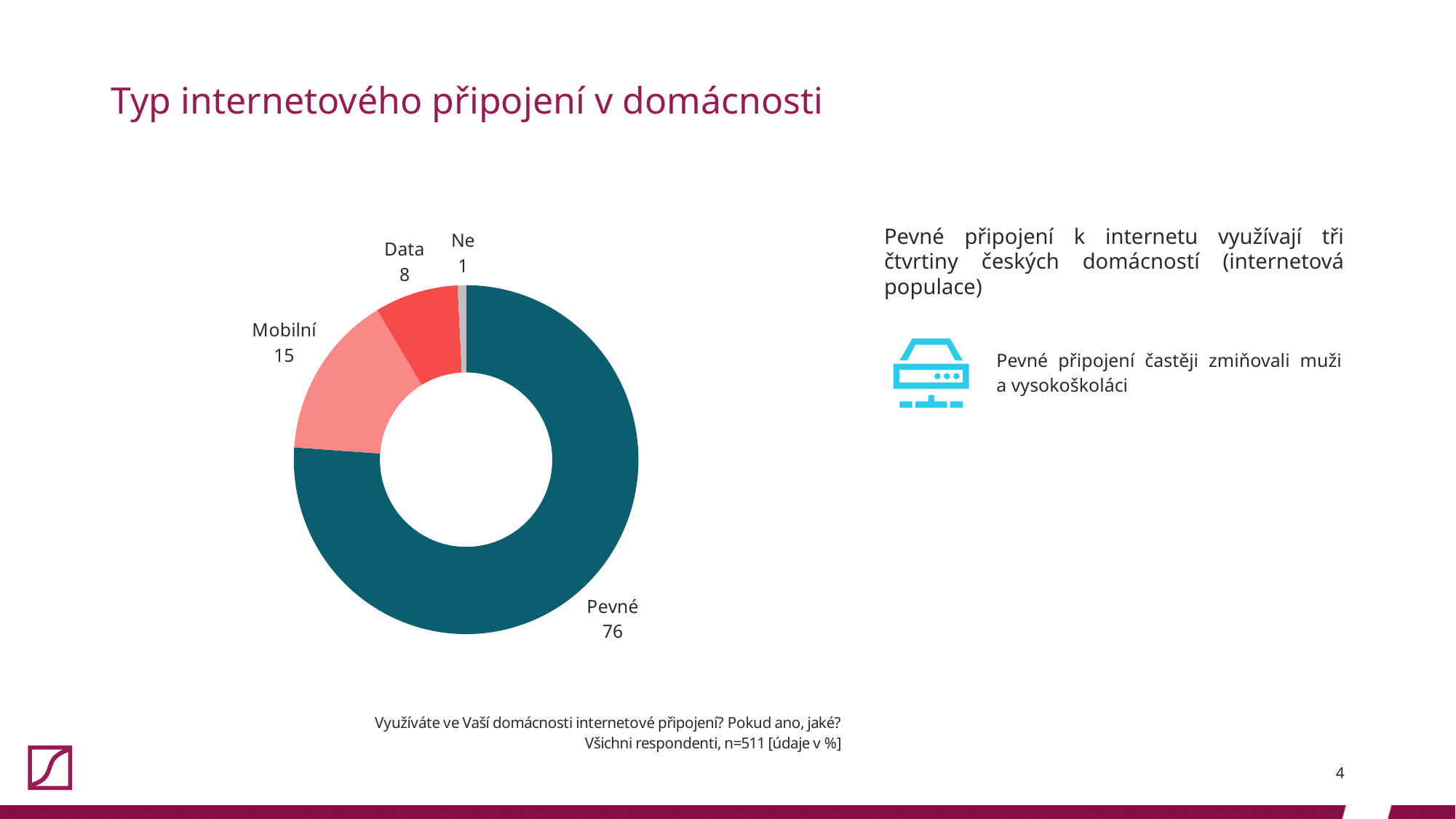
How many categories are shown in the chart? 4 Which is larger, the value for Data or the value for Mobilní? Mobilní What is the value for Mobilní in the chart? 15 Which category has the largest slice in the chart? Pevné What is the title of the slide containing the chart? Typ internetového připojení v domácnosti What kind of chart is shown on the slide? Pie chart (doughnut) What is the difference between the values for Pevné and Mobilní? 61 What is the value for Pevné in the chart? 76 What is the value for Ne in the chart? 1 Which category has the smallest slice in the chart? Ne What is the value for Data in the chart? 8 What is the difference between the values for Mobilní and Data? 7